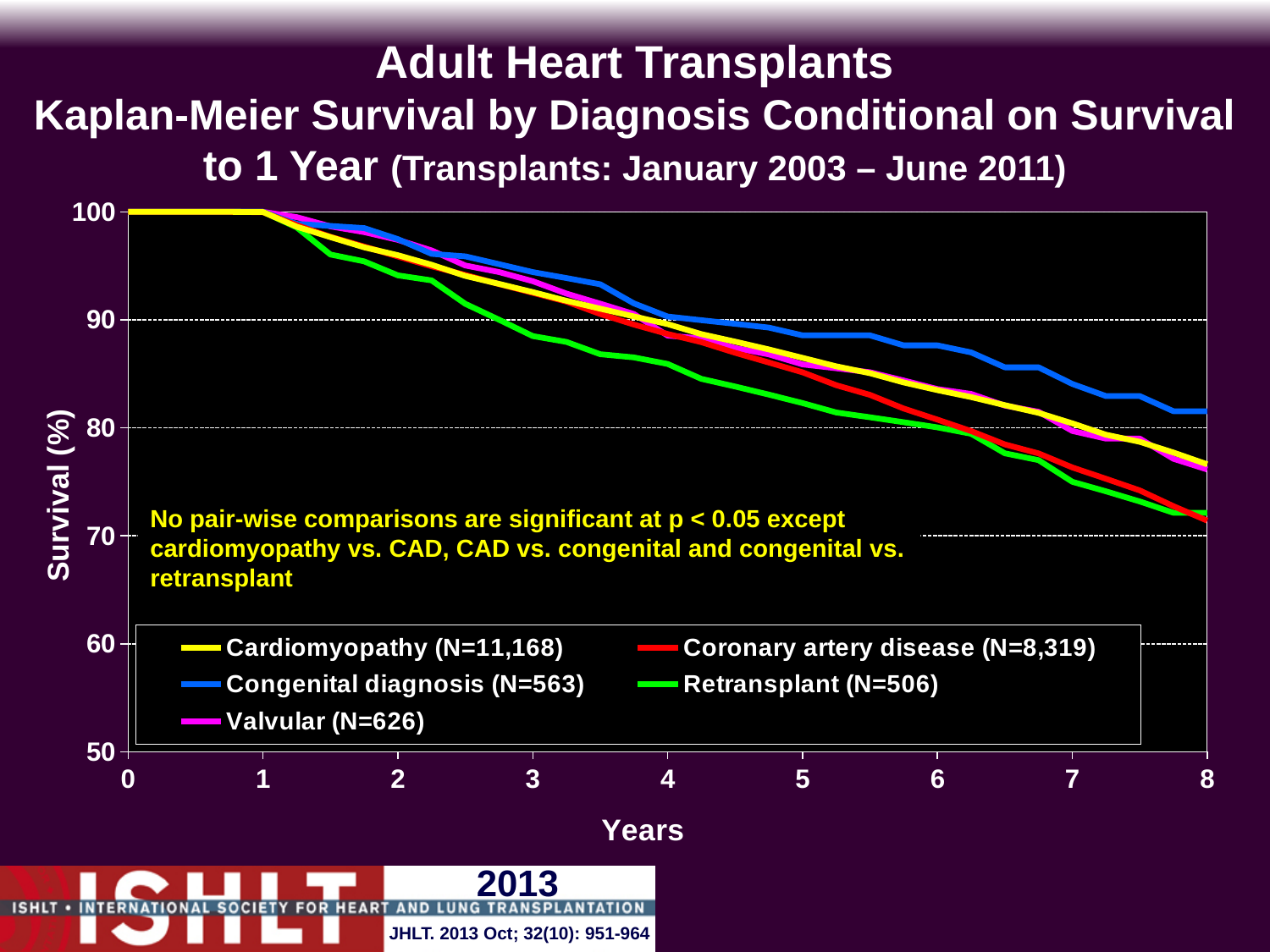
Is the survival for the Retransplant group at 3 years greater or less than 90? less According to the legend, how many patients are in the Cardiomyopathy group? N=11,168 Which diagnosis group has the lowest survival at 4 years? Retransplant At 5 years, which is larger: survival for Congenital diagnosis or for Retransplant? Congenital diagnosis Is the survival for the Congenital diagnosis group at 8 years greater or less than 80? greater How many series does the legend list? 5 According to the legend, how many patients are in the Coronary artery disease group? N=8,319 What kind of chart is shown on the slide? line chart According to the legend, how many patients are in the Retransplant group? N=506 Do the survival curves rise or fall as years increase? fall Which diagnosis group has the highest survival at 8 years? Congenital diagnosis Is the survival for the Retransplant group at 8 years greater or less than 80? less